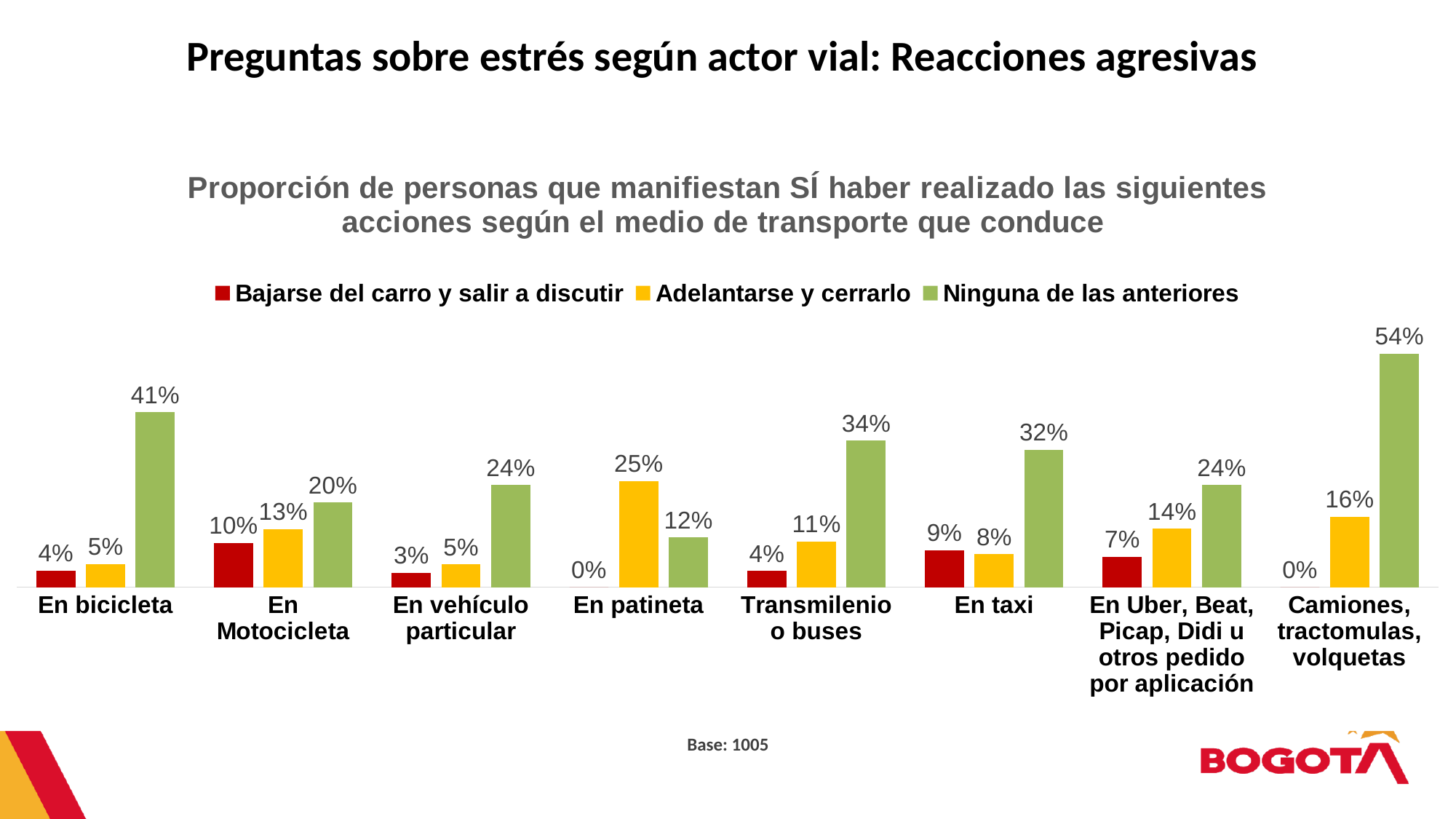
What is the value of 'Ninguna de las anteriores' for 'En bicicleta'? 41% What colour represents the 'Ninguna de las anteriores' series? Green What is the difference between 'Ninguna de las anteriores' for 'Camiones, tractomulas, volquetas' and for 'En taxi'? 22% What kind of chart is shown on the slide? Bar chart Which category has the lowest value for 'Ninguna de las anteriores'? En patineta What is the value of 'Bajarse del carro y salir a discutir' for 'En Motocicleta'? 10% What is the value of 'Adelantarse y cerrarlo' for 'En Uber, Beat, Picap, Didi u otros pedido por aplicación'? 14% How many series does the legend list? 3 How many transport categories are shown on the x axis? 8 What is the value of 'Adelantarse y cerrarlo' for 'En patineta'? 25% Which category has the highest value for 'Ninguna de las anteriores'? Camiones, tractomulas, volquetas Which is larger for 'En taxi': 'Bajarse del carro y salir a discutir' or 'Adelantarse y cerrarlo'? Bajarse del carro y salir a discutir